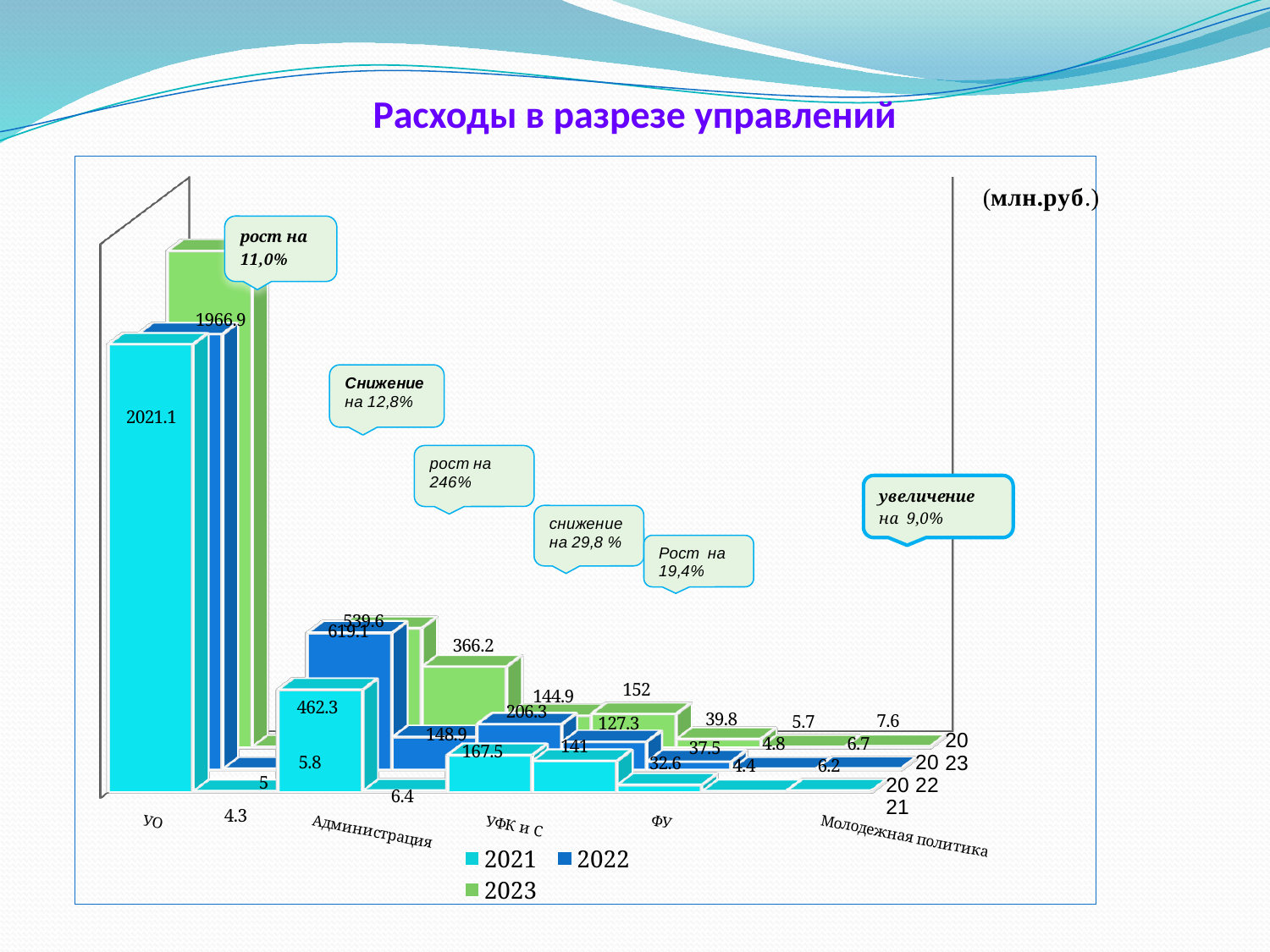
What is the 2022 value for УО? 1966.9 What is the title of the chart? Расходы в разрезе управлений Which is larger for Администрация, the 2021 value or the 2022 value? 2022 What is the 2023 value for Администрация? 539.6 Which years are listed in the legend? 2021, 2022, 2023 What is the difference between the 2022 and 2021 values for Администрация? 156.8 Which category has the highest 2021 value? УО What is the 2022 value for Администрация? 619.1 What is the 2021 value for УО? 2021.1 What type of chart is shown on the slide? bar chart How many series does the legend list? 3 What is the 2021 value for Администрация? 462.3